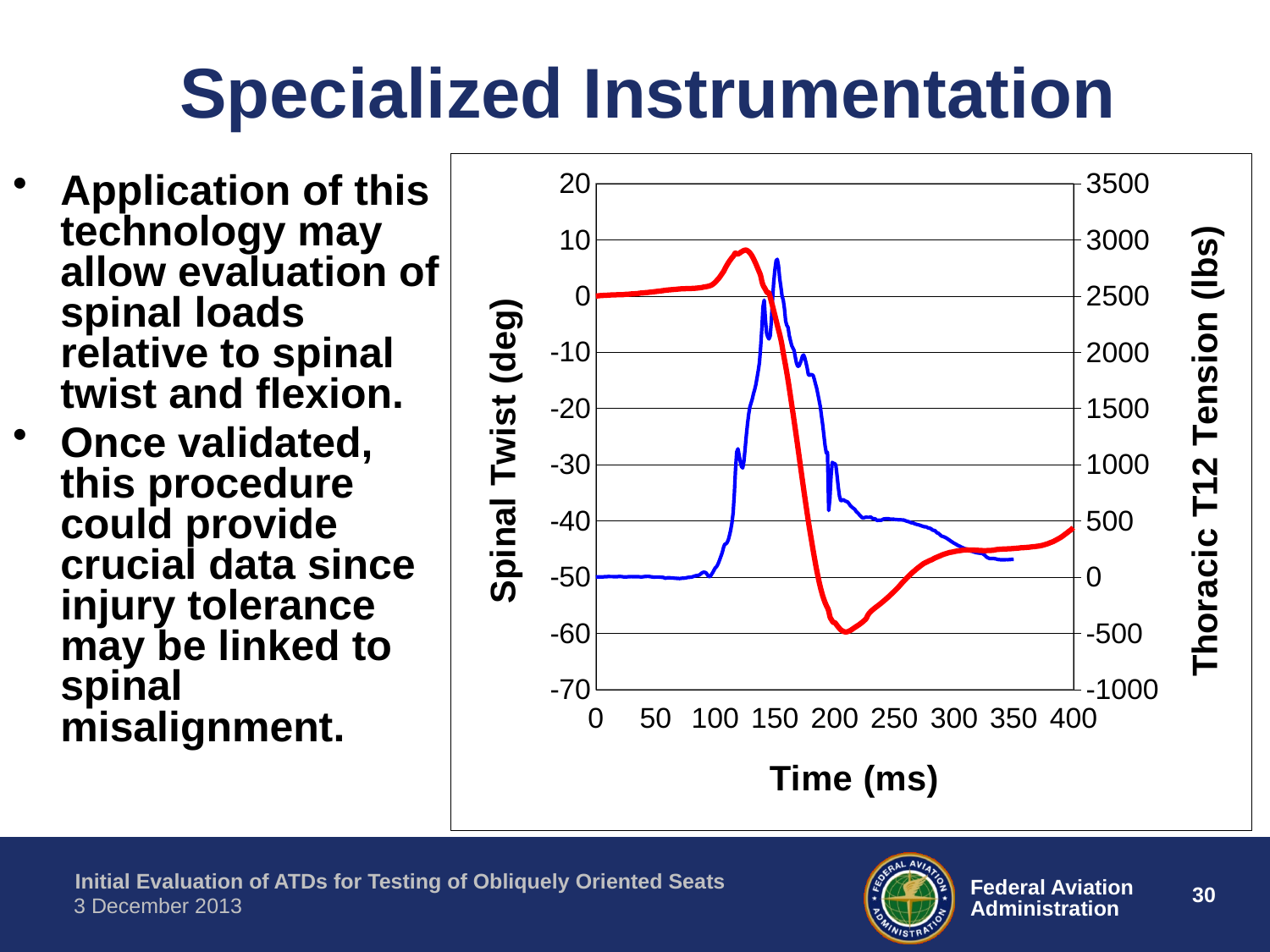
What kind of chart is shown on the slide? line chart At 100 ms, which line is higher on the chart, the red line or the blue line? red line What is the title of the x axis of the chart? Time (ms) Does the red line rise or fall between 0 ms and 100 ms? rise Does the blue line rise or fall between 100 ms and 150 ms? rise Does the blue line rise or fall between 250 ms and 350 ms? fall At 250 ms, which line is higher on the chart, the red line or the blue line? blue line What is the title of the right-hand y axis of the chart? Thoracic T12 Tension (lbs) How many lines are plotted on the chart? 2 Is the lowest point of the red line greater or less than -50 on the left-hand axis? less Is the highest point of the blue line greater or less than 0 on the left-hand axis? greater